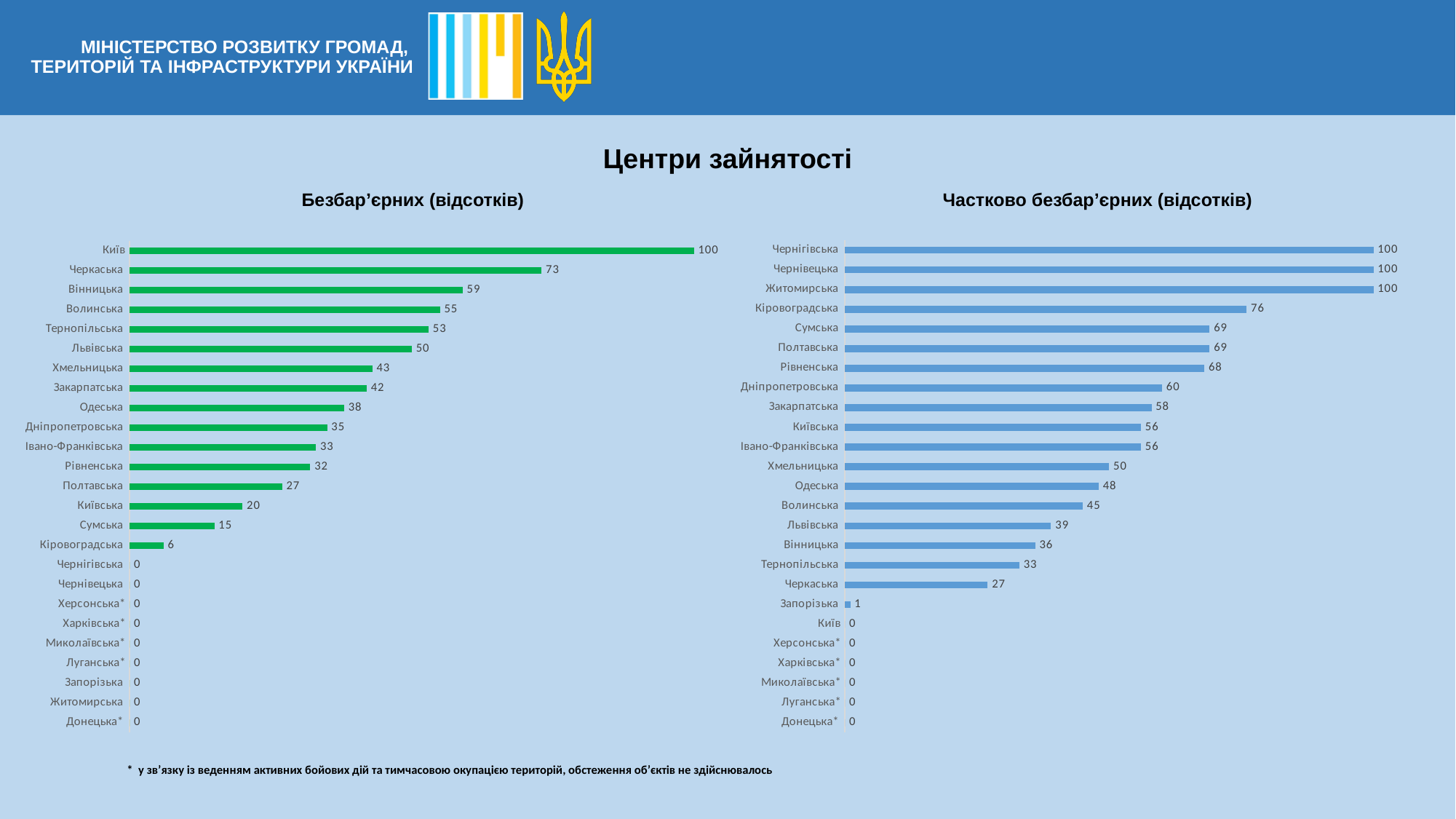
In the chart 'Безбар’єрних (відсотків)', which is larger: the value for Одеська or the value for Полтавська? Одеська What colour are the bars in the chart 'Частково безбар’єрних (відсотків)'? Blue What kind of chart is 'Безбар’єрних (відсотків)'? Bar chart In the chart 'Безбар’єрних (відсотків)', which category has the highest value? Київ In the chart 'Частково безбар’єрних (відсотків)', what is the value for Кіровоградська? 76 How many categories are shown in the chart 'Частково безбар’єрних (відсотків)'? 25 In the chart 'Безбар’єрних (відсотків)', what is the value for Черкаська? 73 In the chart 'Безбар’єрних (відсотків)', what is the difference between the values for Вінницька and Волинська? 4 In the chart 'Частково безбар’єрних (відсотків)', which is larger: the value for Львівська or the value for Вінницька? Львівська In the chart 'Безбар’єрних (відсотків)', what is the value for Кіровоградська? 6 In the chart 'Частково безбар’єрних (відсотків)', what is the value for Запорізька? 1 In the chart 'Частково безбар’єрних (відсотків)', what is the difference between the values for Дніпропетровська and Черкаська? 33